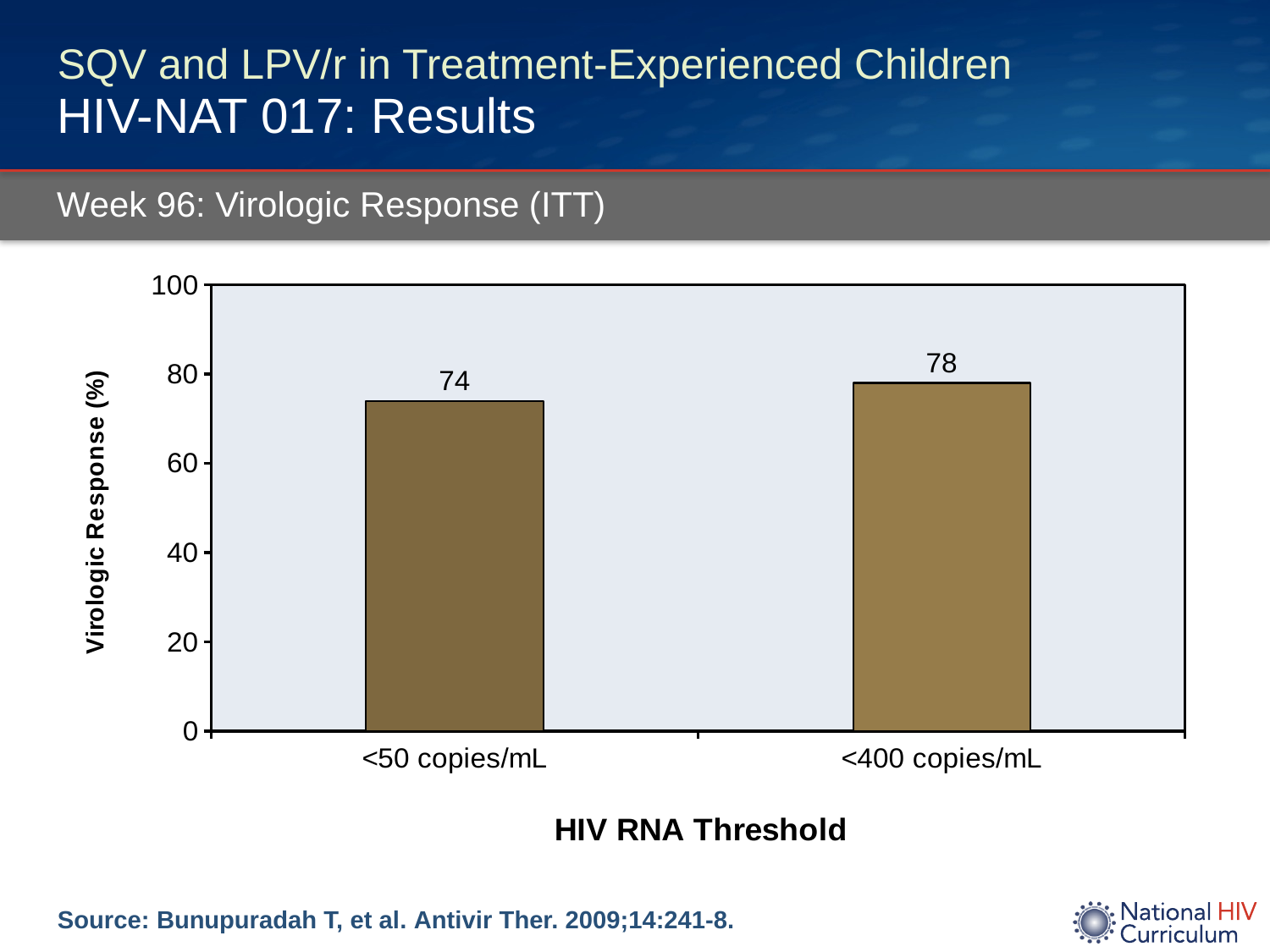
Which HIV RNA threshold has the lower virologic response? <50 copies/mL What is the virologic response (%) for the <50 copies/mL threshold? 74 What is the virologic response (%) for the <400 copies/mL threshold? 78 What is the label of the x-axis? HIV RNA Threshold What is the label of the y-axis? Virologic Response (%) Which HIV RNA threshold has the higher virologic response? <400 copies/mL What type of chart is shown on the slide? bar chart What is the maximum value shown on the y-axis? 100 What is the difference in virologic response between the <400 copies/mL and <50 copies/mL thresholds? 4 How many HIV RNA threshold categories are shown on the chart? 2 Is the virologic response for <400 copies/mL greater or less than 60? greater Is the virologic response for <50 copies/mL greater or less than 80? less